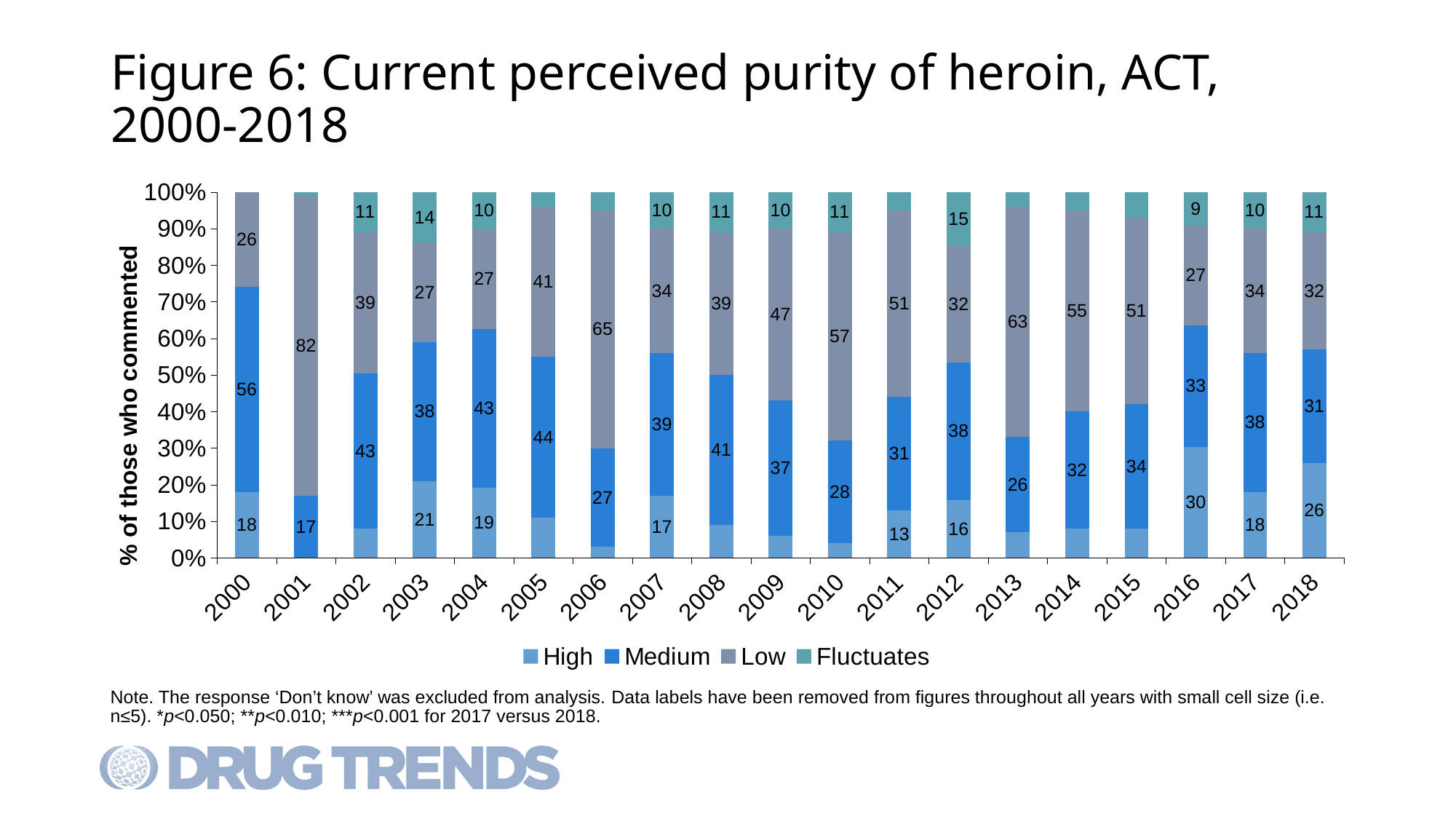
What is the value for Medium in 2000? 56 How many series does the legend list? 4 What is the difference between the Low value in 2001 and the Low value in 2000? 56 What type of chart is shown on the slide? Stacked bar chart What is the value for High in 2018? 26 In which year is the Low segment the largest? 2001 How many years are shown along the x axis? 19 Which is larger, the Medium value in 2017 or the Medium value in 2018? 2017 What is the value for Fluctuates in 2012? 15 What is the value for Low in 2001? 82 Is the value for High in 2006 greater or less than 10%? less In which year is the Medium segment the largest? 2000